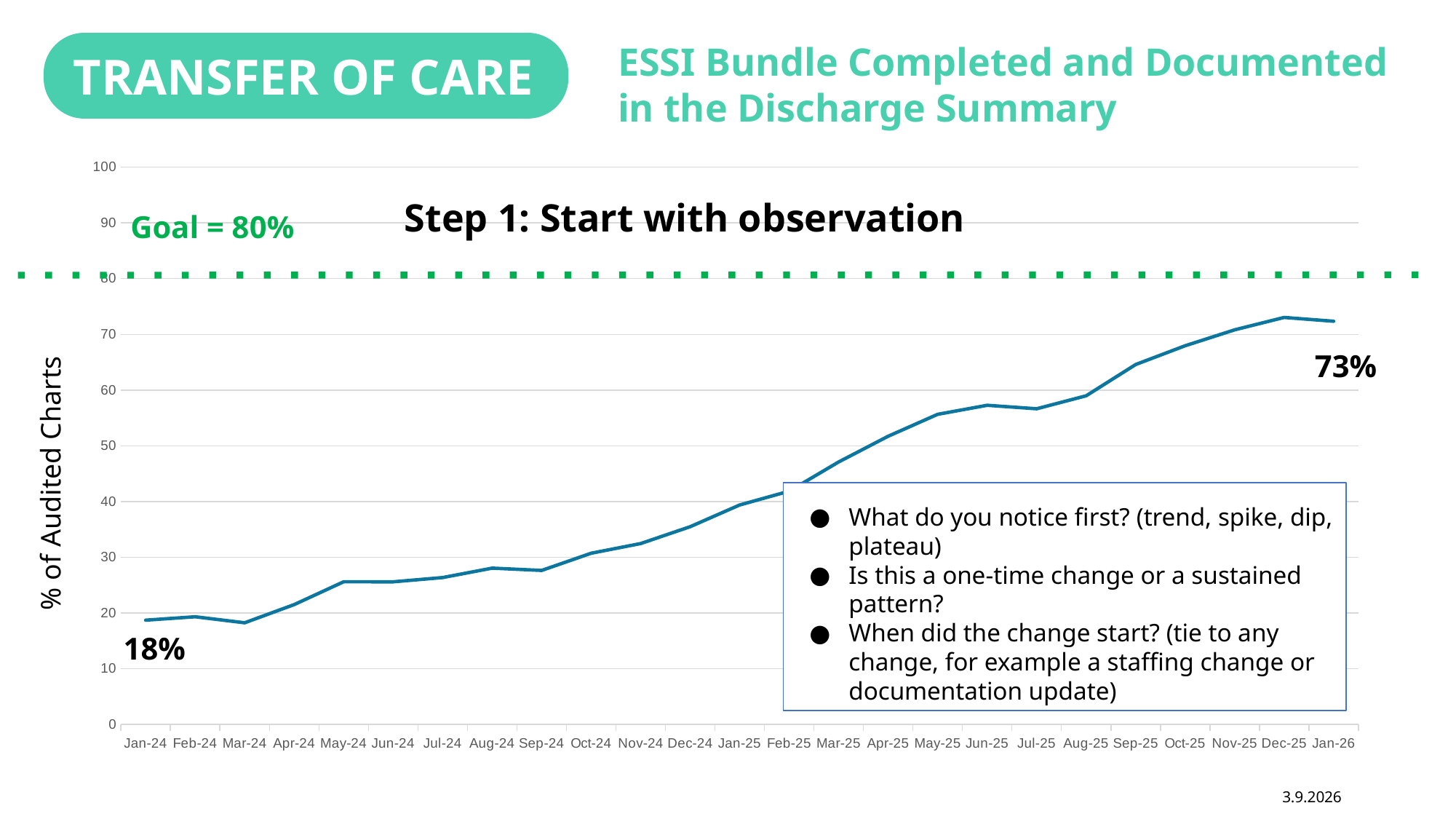
What kind of chart is shown on the slide? line chart Is the value for Mar-25 greater or less than 40? greater Is the final value for Jan-26 greater or less than 80? less What is the difference between the labelled end value (73%) and the labelled start value (18%)? 55 percentage points How many months are plotted along the x axis? 25 Do the values generally rise or fall from Jan-24 to Jan-26? rise What value is labelled at the start of the line (Jan-24)? 18% Is the value for Sep-25 greater or less than 60? greater Which is larger, the value for Jan-26 or the value for Jan-24? Jan-26 What goal value is marked by the dashed line on the chart? 80% What value is labelled at the end of the line? 73%